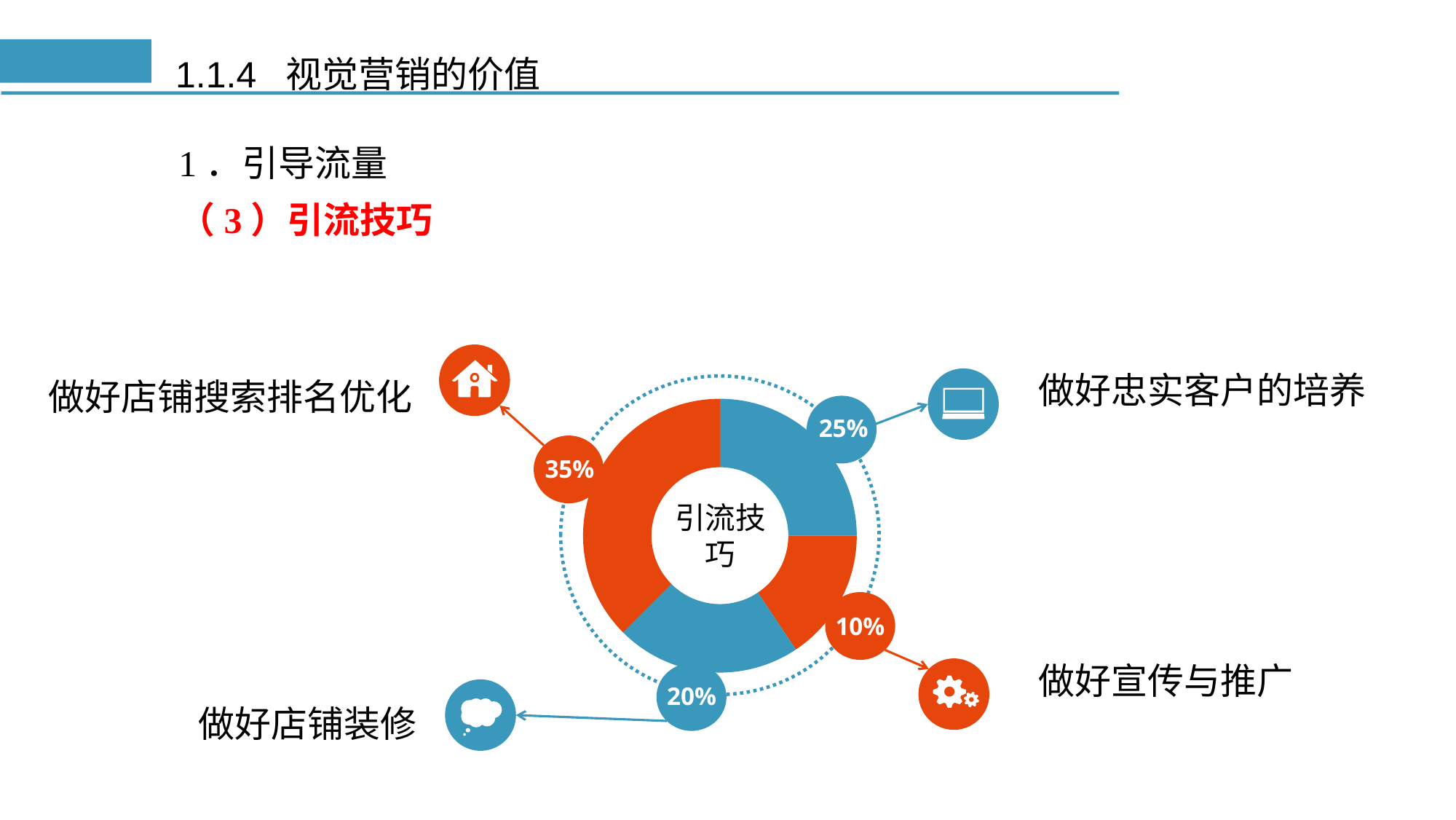
How many segments does the donut chart have? 4 What percentage is shown for 做好店铺装修? 20% What is the difference in percentage points between 做好店铺搜索排名优化 and 做好店铺装修? 15% What is the total of the four percentages shown on the chart? 90% Which is larger, the share for 做好忠实客户的培养 or the share for 做好店铺装修? 做好忠实客户的培养 What percentage is shown for 做好宣传与推广? 10% What percentage is shown for 做好店铺搜索排名优化? 35% What percentage is shown for 做好忠实客户的培养? 25% Which category has the largest share of the donut chart? 做好店铺搜索排名优化 Which category has the smallest share of the donut chart? 做好宣传与推广 What kind of chart is shown on the slide? Donut (pie) chart What text appears in the centre of the donut chart? 引流技巧